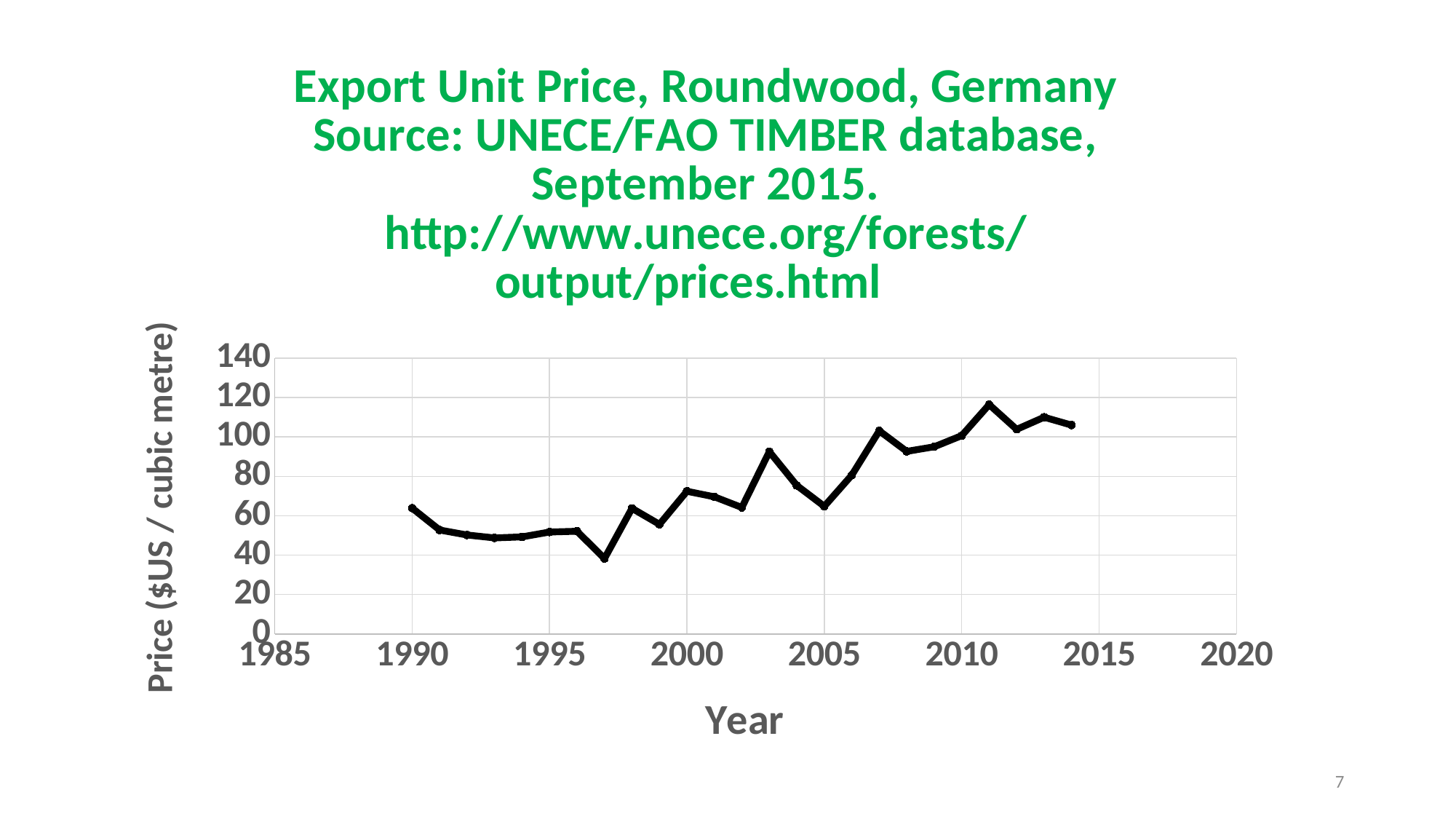
In which year is the export unit price lowest? 1997 Is the value for 2011 greater or less than 100? greater Is the value for 2003 greater or less than 80? greater Which year has the larger export unit price, 2003 or 1997? 2003 Is the value for 2007 greater or less than 80? greater In which year is the export unit price highest? 2011 What kind of chart is shown on the slide? line chart Which year has the larger export unit price, 1990 or 2011? 2011 What is the label of the vertical axis? Price ($US / cubic metre) Overall, does the export unit price rise or fall from 1990 to 2014? rise